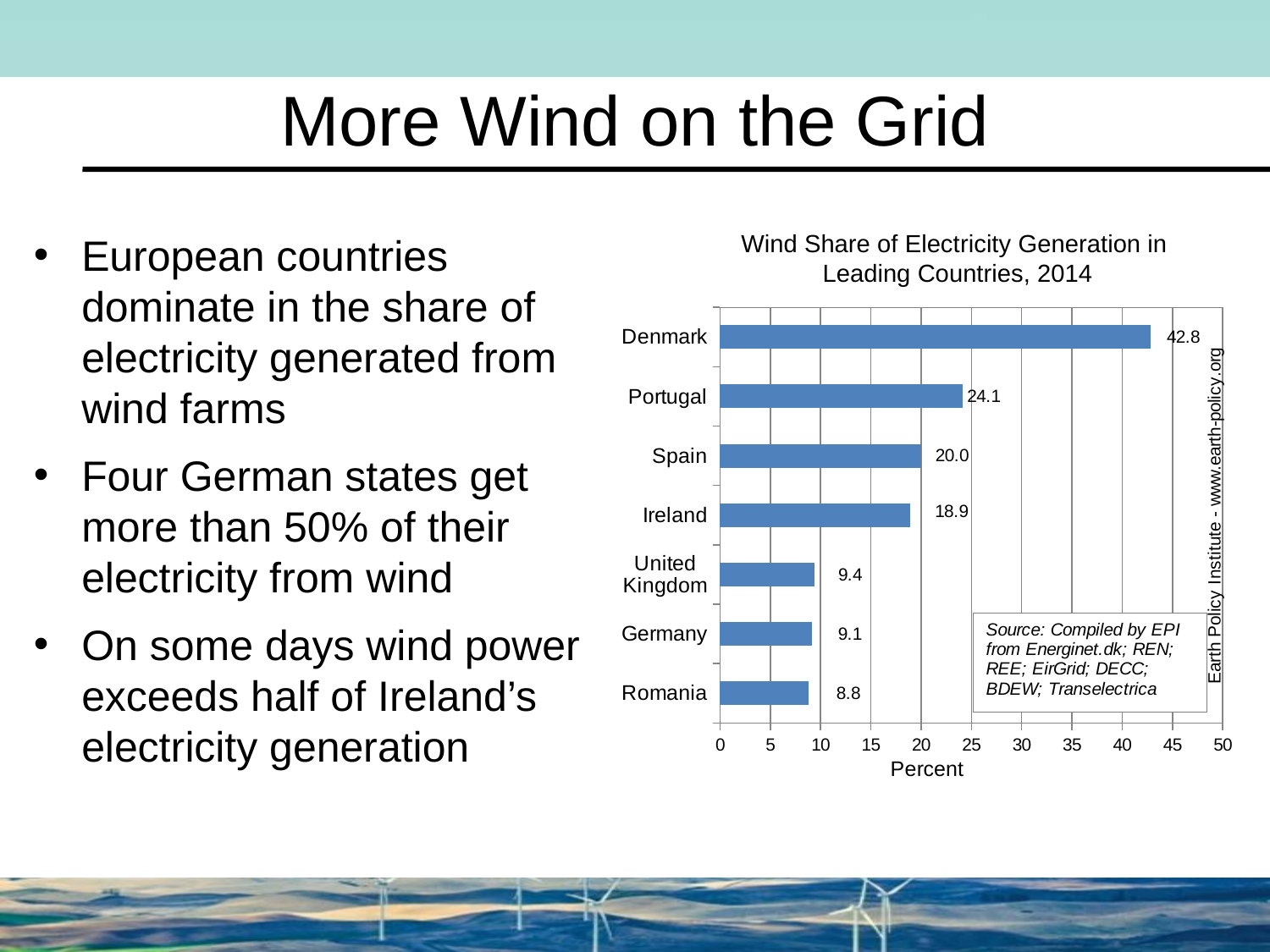
What is the wind share of electricity generation for Denmark? 42.8 Which country has the highest wind share of electricity generation? Denmark Which country has the lowest wind share of electricity generation? Romania What is the wind share of electricity generation for Romania? 8.8 Is the value for Denmark greater or less than 40? greater What is the title of the chart? Wind Share of Electricity Generation in Leading Countries, 2014 What is the difference between Denmark's and Portugal's wind share of electricity generation? 18.7 What is the wind share of electricity generation for Spain? 20.0 How many countries are shown in the chart? 7 Which has a larger wind share of electricity generation, Portugal or Ireland? Portugal What is the difference between Spain's and Ireland's wind share of electricity generation? 1.1 What kind of chart is shown on the slide? Bar chart